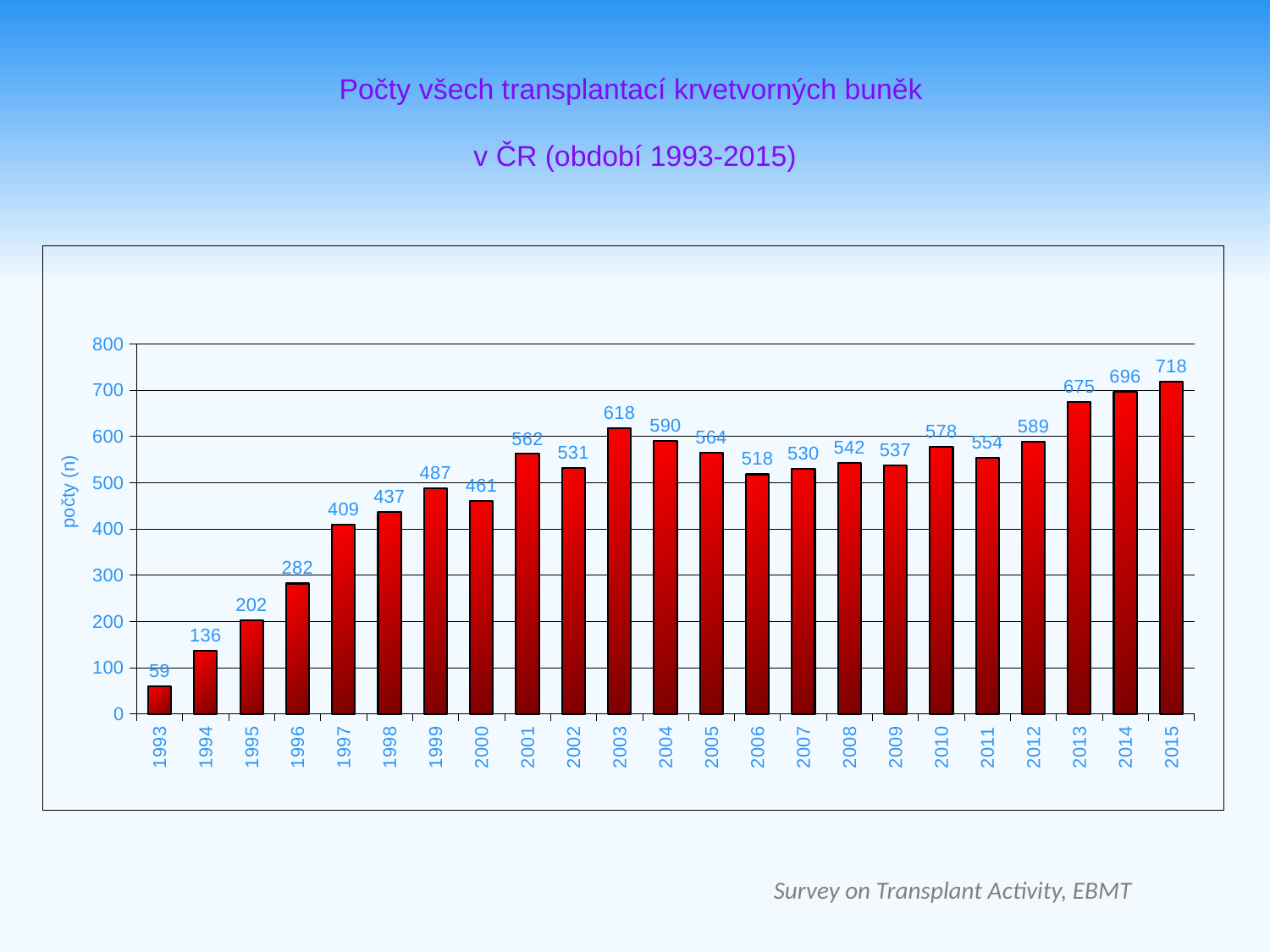
Which year has the lowest value? 1993 What is the value for 1993? 59 What is the difference between the values for 2003 and 2002? 87 What is the label of the y axis? počty (n) How many years are shown on the x axis? 23 What kind of chart is shown on the slide? bar chart What is the value for 2003? 618 Is the value for 2013 greater or less than 600? greater What is the difference between the values for 2015 and 2014? 22 Which is larger, the value for 2004 or the value for 2005? 2004 Which year has the highest value? 2015 What is the value for 2010? 578